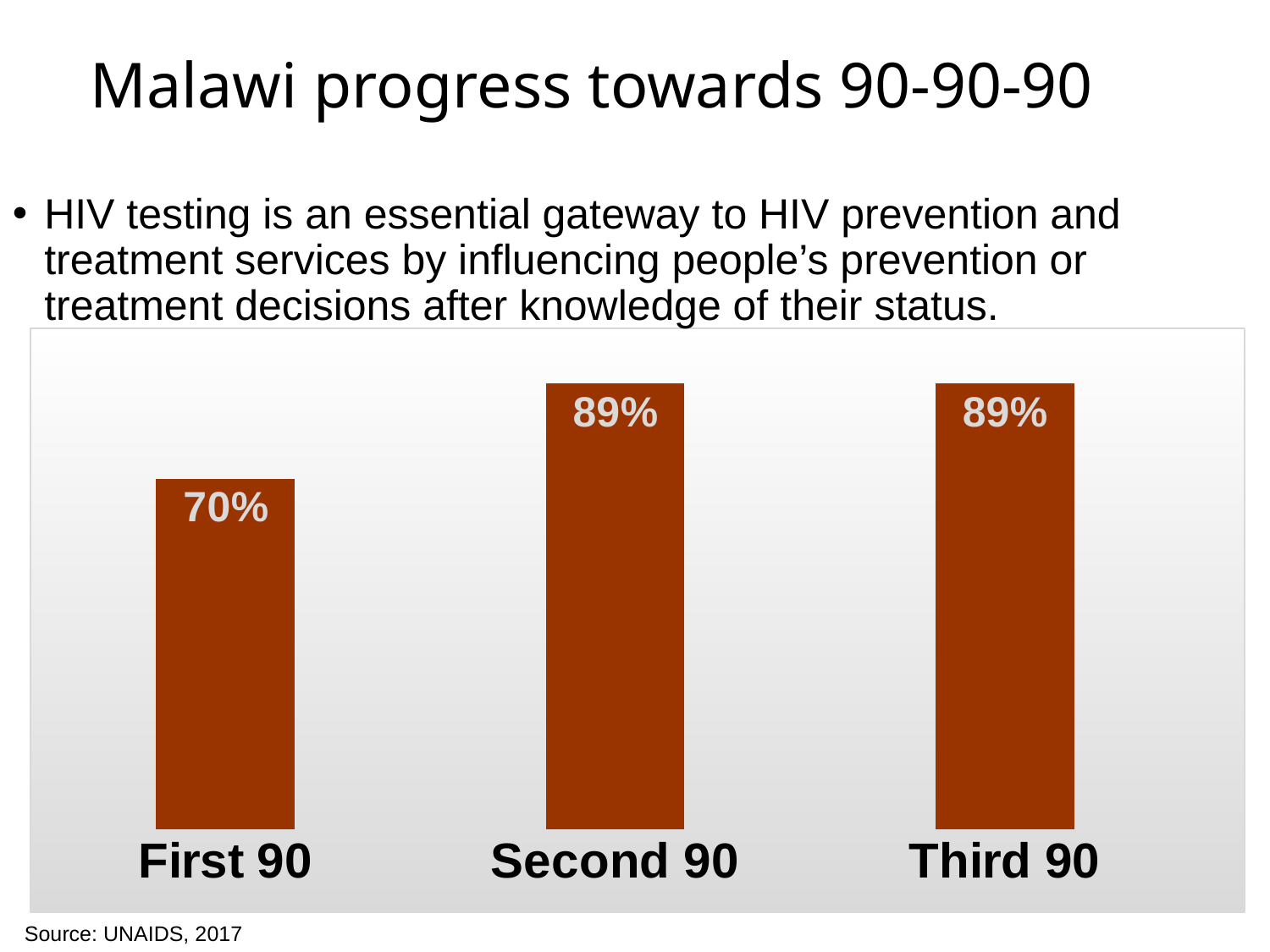
What is the difference between the values for Second 90 and Third 90? 0% What is the difference between the values for Second 90 and First 90? 19% What is the value for First 90? 70% What is the value for Second 90? 89% Do the values rise or fall from First 90 to Second 90? Rise What is the title of the slide containing the chart? Malawi progress towards 90-90-90 What is the value for Third 90? 89% What source is cited below the chart? UNAIDS, 2017 Which category has the lowest value? First 90 Which is larger, the value for First 90 or the value for Third 90? Third 90 How many categories are shown in the chart? 3 What kind of chart is shown on the slide? Bar chart